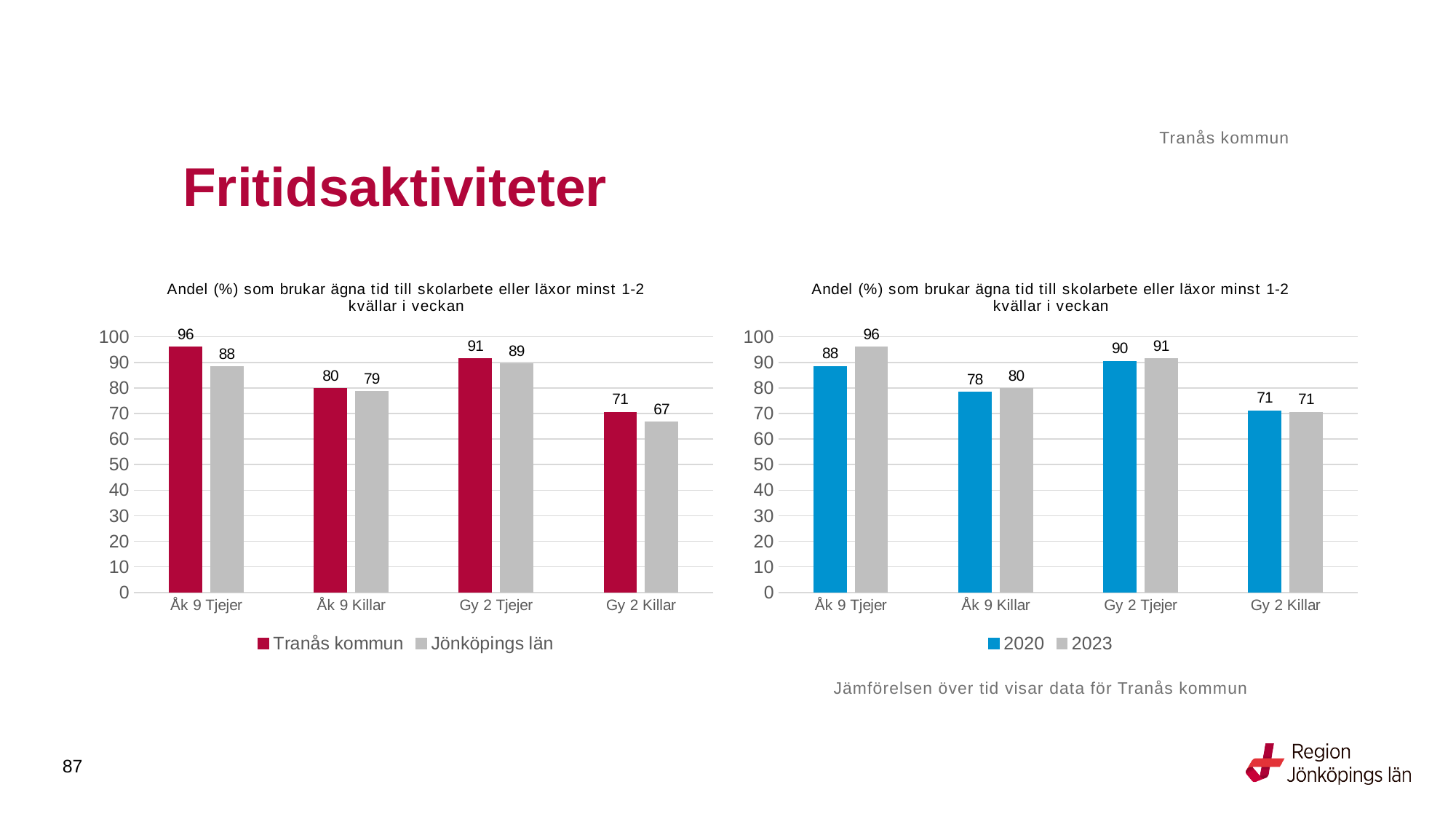
In the left chart, what is the value for Tranås kommun for Åk 9 Tjejer? 96 In the left chart, what is the difference between Tranås kommun and Jönköpings län for Åk 9 Tjejer? 8 In the right chart, how many categories are shown on the x axis? 4 In the right chart, what is the value for 2020 for Åk 9 Killar? 78 In the right chart, which is larger for Åk 9 Tjejer: 2020 or 2023? 2023 In the right chart, what is the value for 2023 for Gy 2 Tjejer? 91 In the left chart, what is the value for Jönköpings län for Gy 2 Killar? 67 In the left chart, which category has the lowest value for Tranås kommun? Gy 2 Killar In the right chart, what is the difference between 2023 and 2020 for Åk 9 Tjejer? 8 In the left chart, how many series does the legend list? 2 What kind of chart is the left chart? Bar chart In the right chart, which category has the highest value for 2023? Åk 9 Tjejer